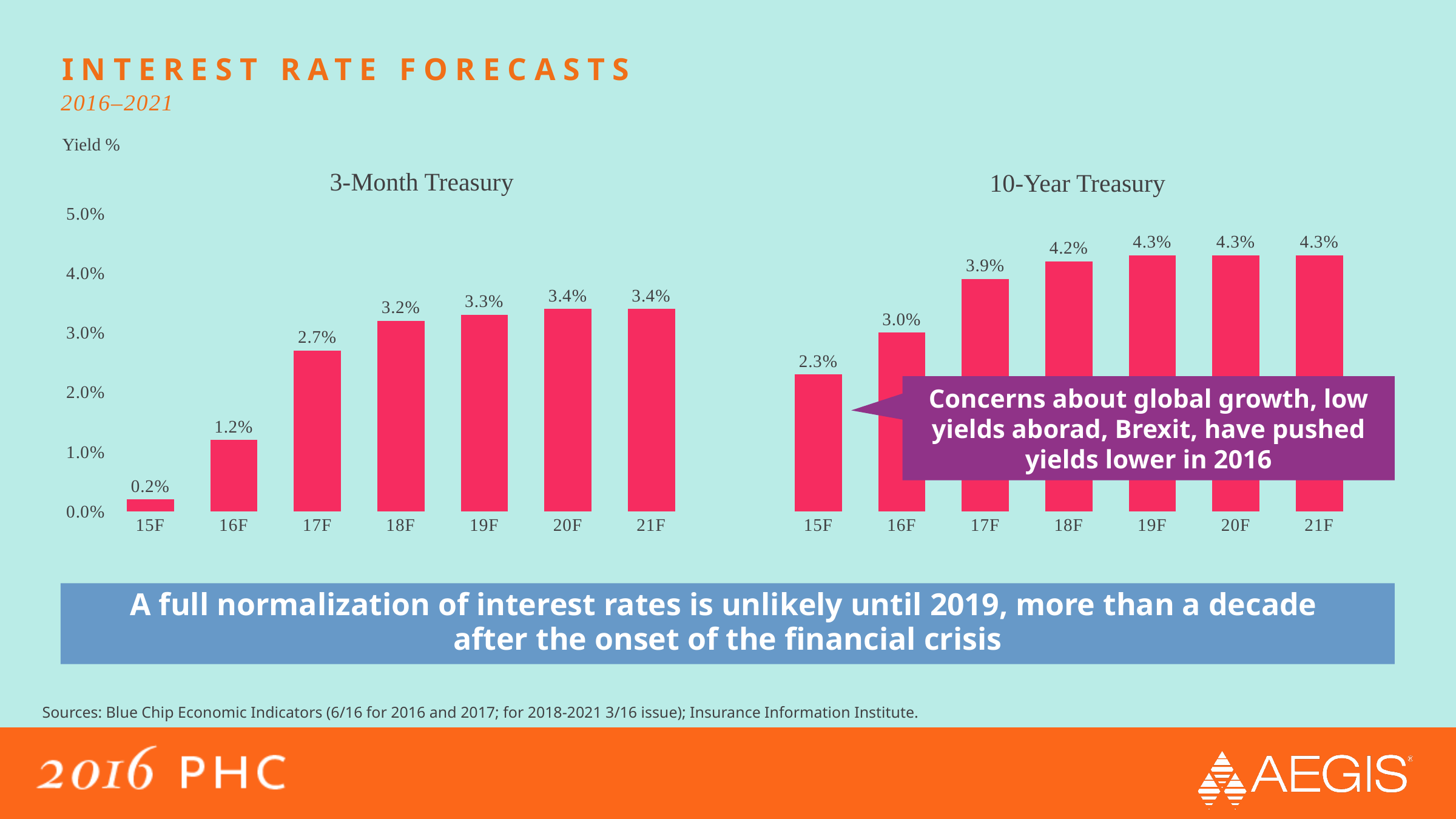
How many categories are shown in the 3-Month Treasury chart? 7 In the 3-Month Treasury chart, what is the difference between the values for 18F and 16F? 2.0% In the 3-Month Treasury chart, which is larger, the value for 16F or the value for 17F? 17F In the 10-Year Treasury chart, what is the difference between the values for 17F and 15F? 1.6% In the 10-Year Treasury chart, is the value for 18F greater or less than 4.0%? greater In the 10-Year Treasury chart, what is the value for 16F? 3.0% In the 3-Month Treasury chart, do the values rise or fall from 15F to 21F? rise In the 10-Year Treasury chart, which category has the lowest value? 15F What kind of chart is the 10-Year Treasury chart? bar chart What is the title of the slide? Interest Rate Forecasts In the 3-Month Treasury chart, what is the value for 17F? 2.7% In the 3-Month Treasury chart, which category has the lowest value? 15F